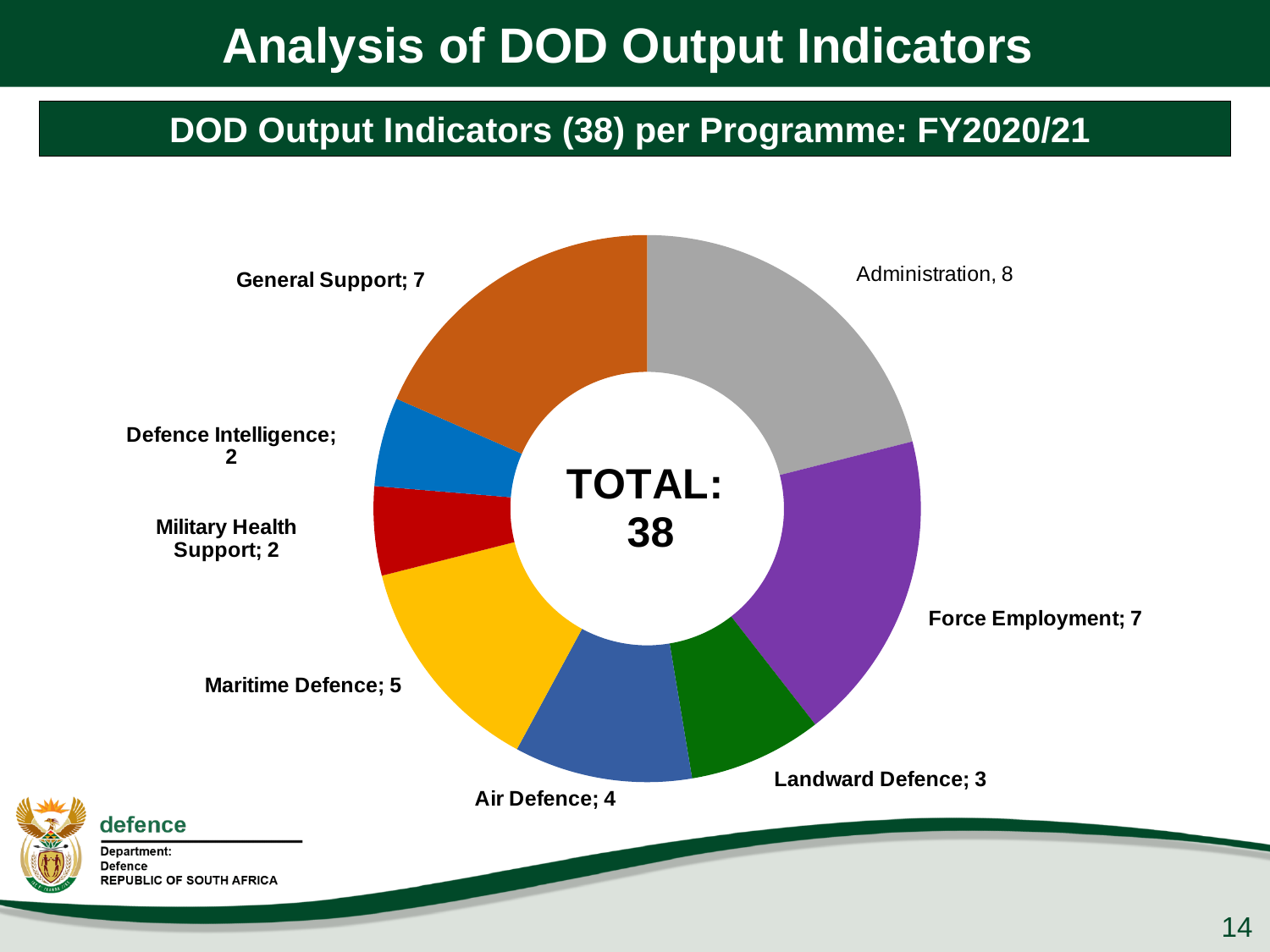
Which is larger, the value for Maritime Defence or the value for Air Defence? Maritime Defence What is the value for Landward Defence? 3 How many output indicators does the Administration programme have? 8 What is the difference between the values for Administration and Landward Defence? 5 What is the value for Maritime Defence? 5 What is the value for Air Defence? 4 Which programme has the highest number of output indicators? Administration What is the title shown above the chart? DOD Output Indicators (38) per Programme: FY2020/21 Which two programmes have the lowest number of output indicators? Military Health Support and Defence Intelligence What type of chart is shown on the slide? Pie chart (doughnut) How many programmes (categories) are shown in the chart? 8 What is the total number of output indicators shown in the centre of the chart? 38